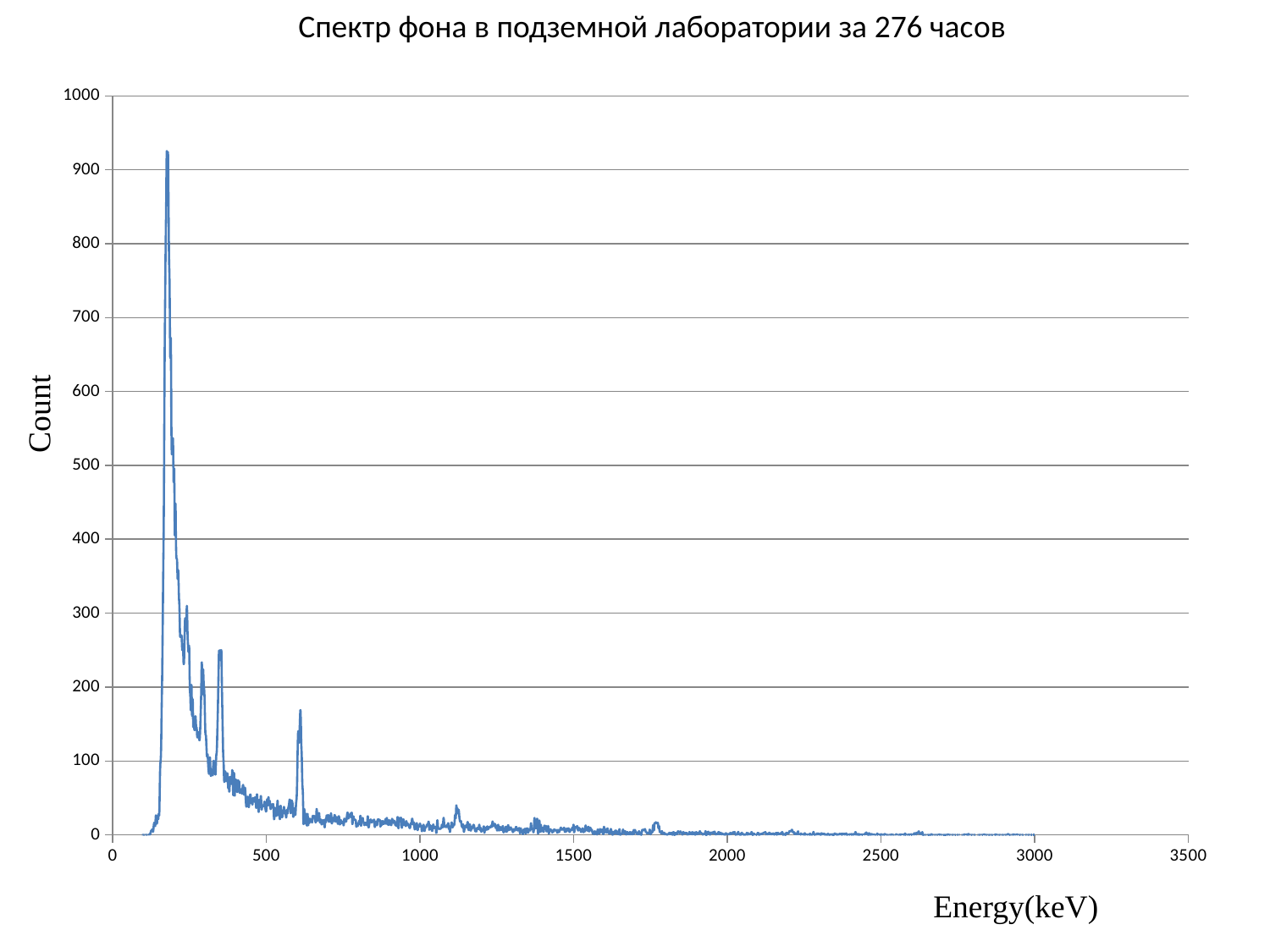
Is the count at the peak near 600 keV greater or less than 100? greater Is the count at the highest peak of the spectrum greater or less than 900? greater Is the energy at which the highest peak occurs greater or less than 500 keV? less What kind of chart is shown on the slide? line chart What is the title of the chart? Спектр фона в подземной лаборатории за 276 часов What is the label of the horizontal axis? Energy(keV) After the main peak, do the counts generally rise or fall as energy increases? fall What is the highest value shown on the vertical (Count) axis? 1000 How many lines (data series) are plotted on the chart? 1